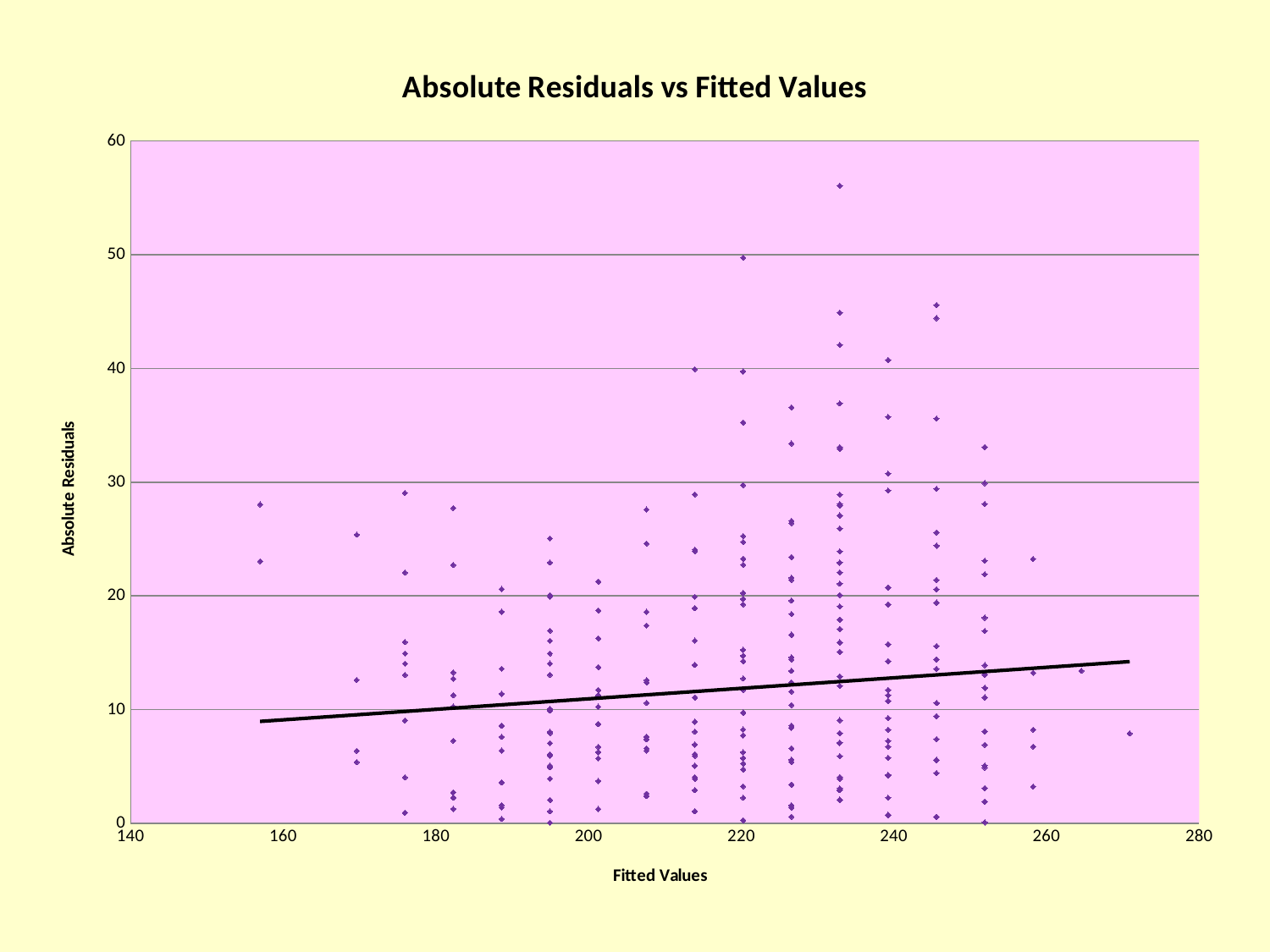
What kind of chart is shown on the slide? Scatter chart What is the label on the horizontal axis of the chart? Fitted Values Is the trend line's value at a fitted value of 160 greater or less than 10? less Is the absolute residual of the rightmost point on the chart greater or less than 10? less Is the trend line higher at a fitted value of 160 or at a fitted value of 270? 270 Is the second-highest point on the chart (near a fitted value of 220) greater or less than 40 in absolute residual? greater Does the fitted trend line rise or fall as Fitted Values increase along the x axis? Rise What is the title of the chart? Absolute Residuals vs Fitted Values